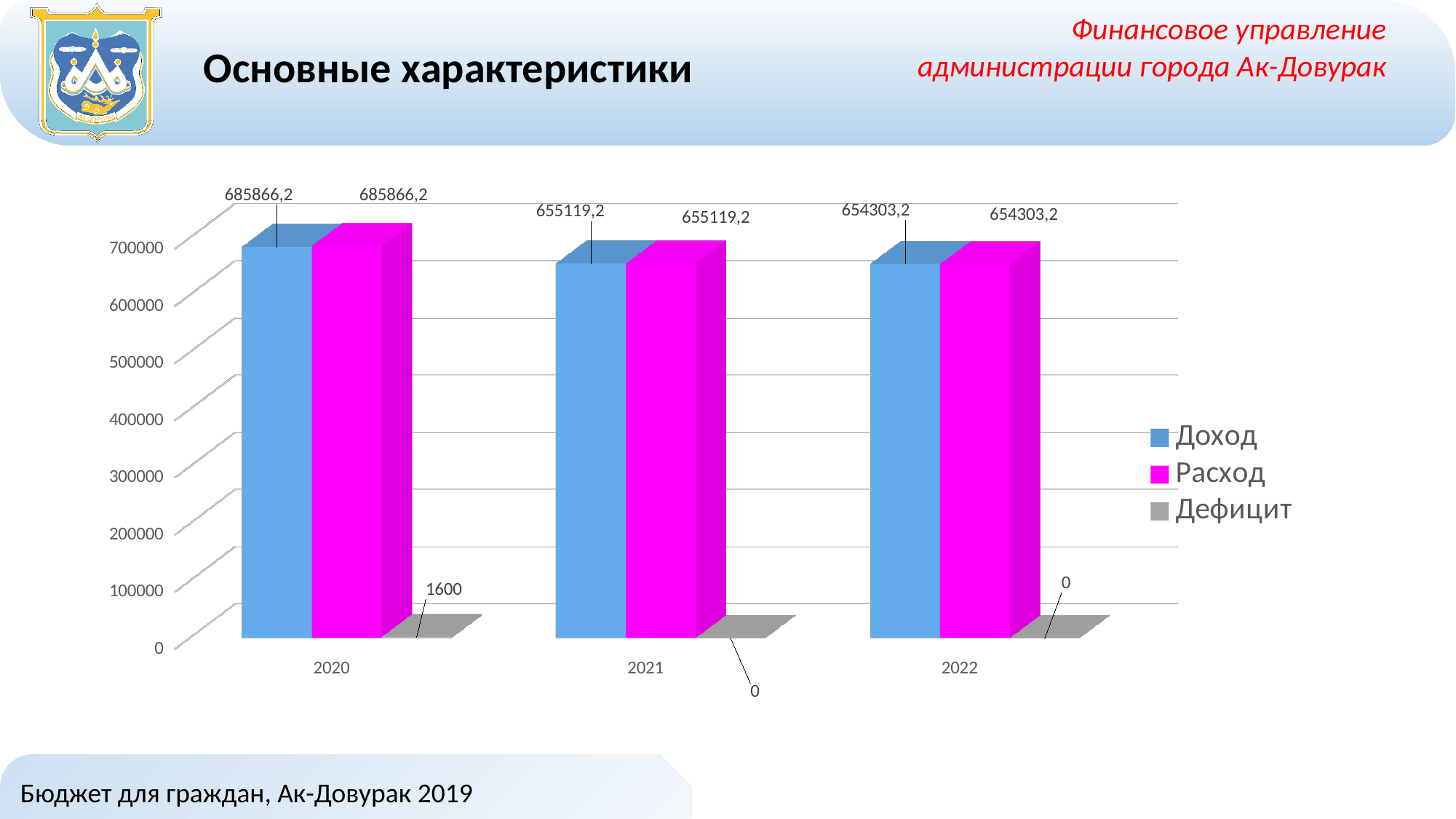
In which year is Расход lowest? 2022 What is the value of Дефицит for 2022? 0 How many series does the legend list? 3 How many years are shown on the x axis? 3 What kind of chart is shown on the slide? Bar chart What is the value of Доход for 2022? 654303,2 Which is larger: Расход in 2021 or Расход in 2022? Расход in 2021 What is the value of Дефицит for 2020? 1600 What is the difference between Доход in 2020 and Доход in 2021? 30747 In which year is Доход highest? 2020 What is the value of Расход for 2021? 655119,2 What is the value of Доход for 2020? 685866,2